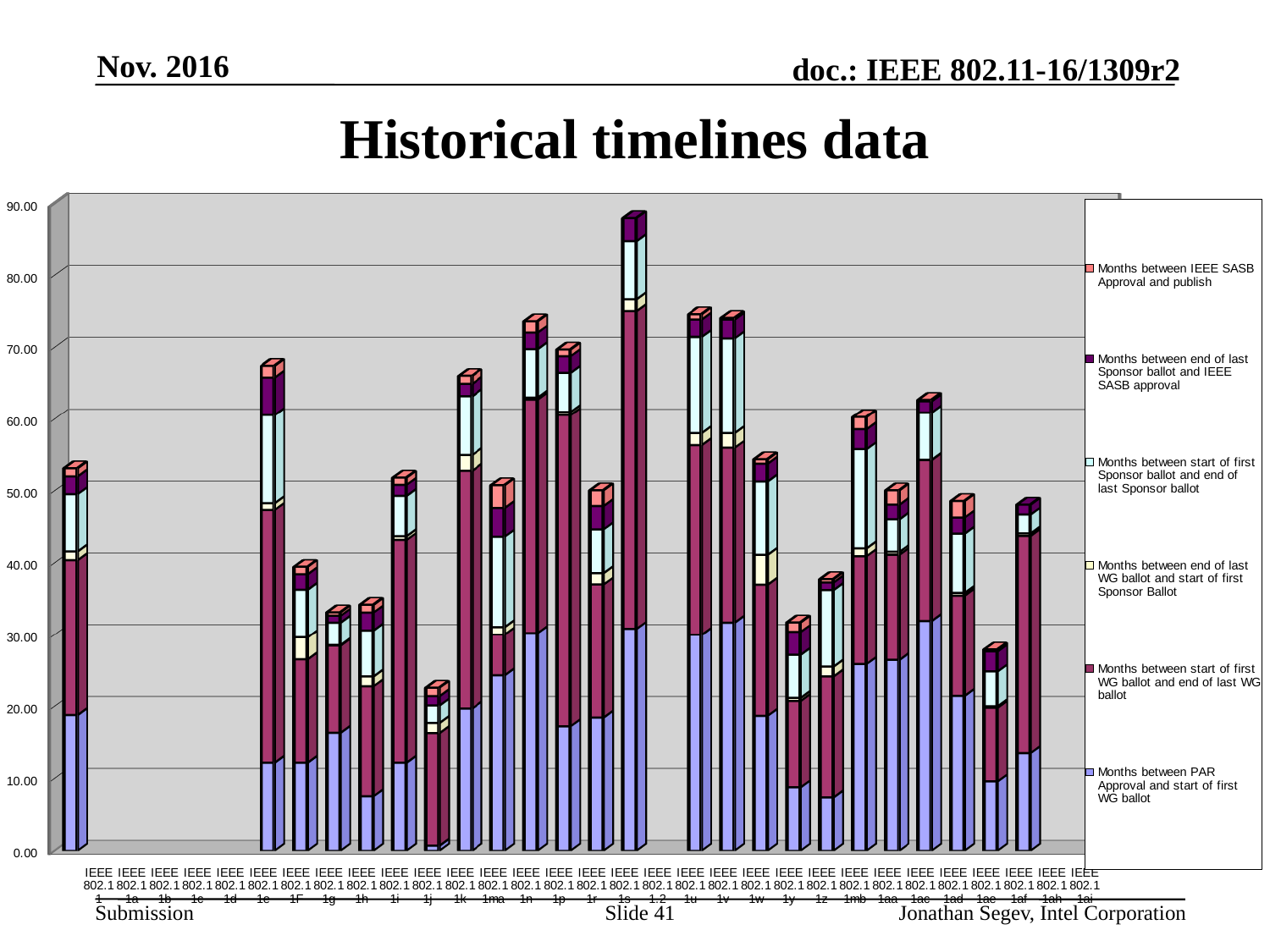
Is the total of the tallest bar greater or less than 80? greater Is the total of the shortest bar greater or less than 30? less What is the title of the chart? Historical timelines data Is the total of the tallest bar greater or less than 90? less How many category labels are shown along the x axis? 31 Which series does the bottom (blue) segment of each bar represent? Months between PAR Approval and start of first WG ballot What kind of chart is shown on the slide? stacked bar chart How many series does the legend list? 6